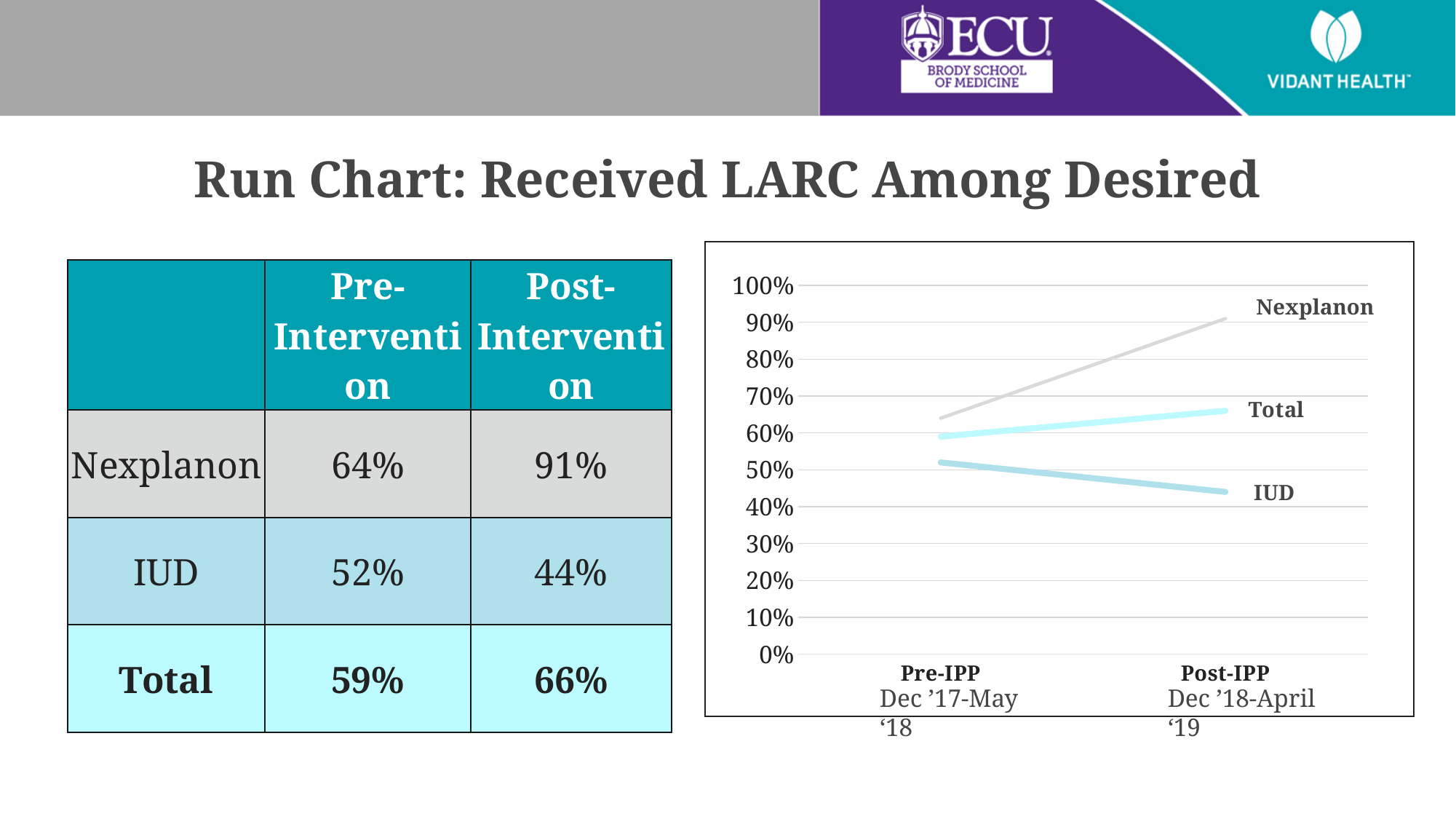
What is the Nexplanon value at Post-Intervention, as printed in the table? 91% What is the difference between the Total Post-Intervention and Pre-Intervention values shown in the table? 7% How many points along the x axis does the line chart have? 2 Does the Nexplanon line rise or fall from Pre-IPP to Post-IPP? rise Which series has the lowest value at Post-IPP in the line chart? IUD At Pre-IPP, which is larger in the line chart: the Nexplanon value or the IUD value? Nexplanon How many series are plotted in the line chart? 3 Which series has the highest value at Post-IPP in the line chart? Nexplanon What kind of chart is shown on the right of the slide? line chart Is the Nexplanon value at Post-IPP greater or less than 80%? greater Does the IUD line rise or fall from Pre-IPP to Post-IPP? fall Is the IUD value at Post-IPP greater or less than 50%? less